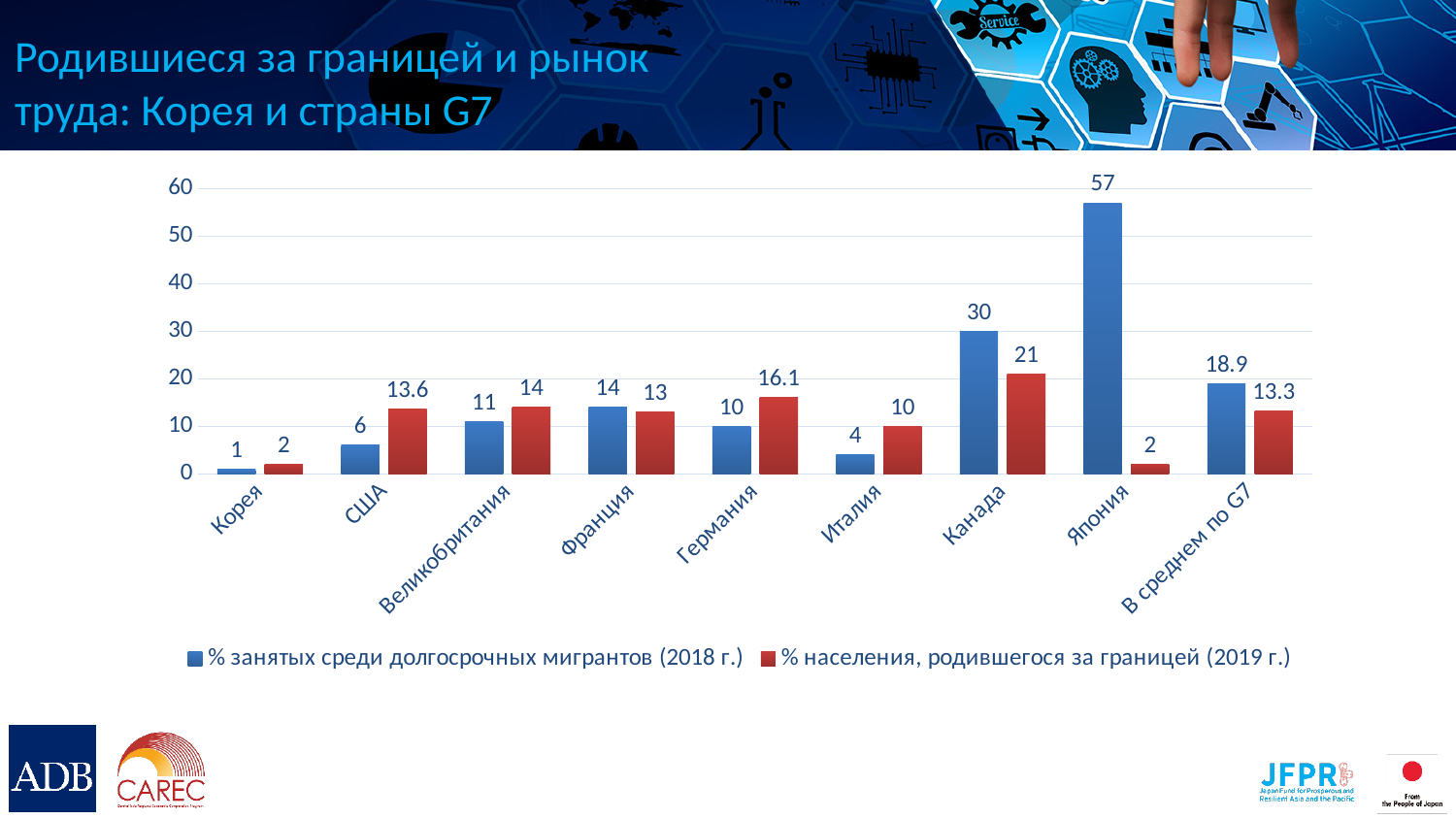
How many categories are shown on the x axis of the chart? 9 How many series does the legend list? 2 What is the value for В среднем по G7 in the series '% занятых среди долгосрочных мигрантов (2018 г.)'? 18.9 What colour are the bars for the series '% населения, родившегося за границей (2019 г.)'? red For США, which series has the larger value: '% занятых среди долгосрочных мигрантов (2018 г.)' or '% населения, родившегося за границей (2019 г.)'? % населения, родившегося за границей (2019 г.) What kind of chart is shown on the slide? bar chart Which category has the highest value in the series '% занятых среди долгосрочных мигрантов (2018 г.)'? Япония Is the value for Япония in the series '% занятых среди долгосрочных мигрантов (2018 г.)' greater or less than 50? greater What is the value for Германия in the series '% населения, родившегося за границей (2019 г.)'? 16.1 What is the difference between the two series values for Канада? 9 What is the value for Япония in the series '% занятых среди долгосрочных мигрантов (2018 г.)'? 57